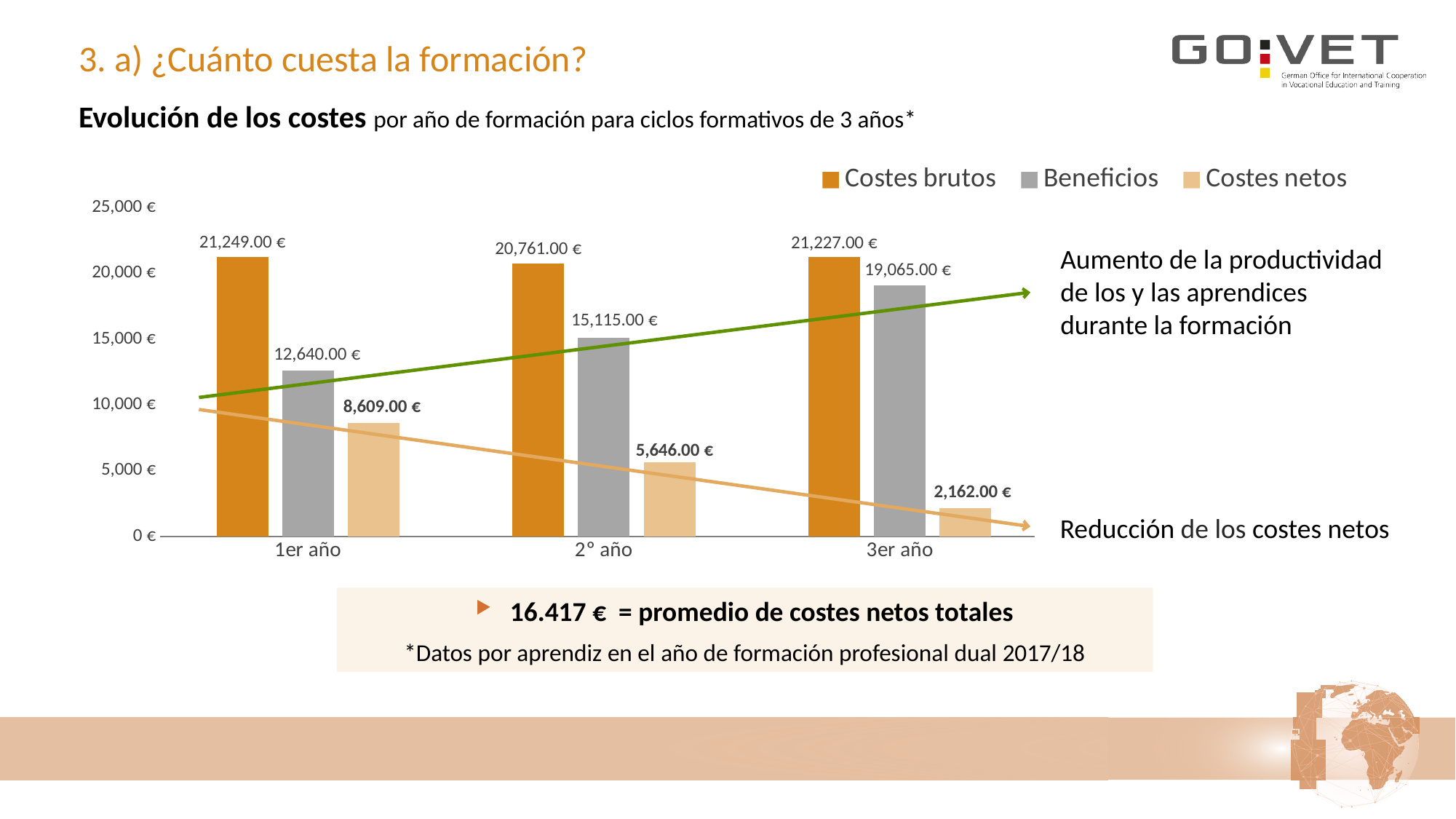
How many year categories are shown on the x axis? 3 What is the value of Beneficios for 2° año? 15,115.00 € Which year has the lowest Costes netos value? 3er año Do the Costes netos values rise or fall from 1er año to 3er año? Fall Which year has the highest Beneficios value? 3er año What is the value of Costes brutos for 1er año? 21,249.00 € What is the value of Beneficios for 3er año? 19,065.00 € What is the value of Costes netos for 3er año? 2,162.00 € How many series does the legend list? 3 What is the difference between Costes brutos and Beneficios for 1er año? 8,609.00 € Which is larger: Costes netos for 1er año or Costes netos for 2° año? Costes netos for 1er año What kind of chart is shown on the slide? Bar chart